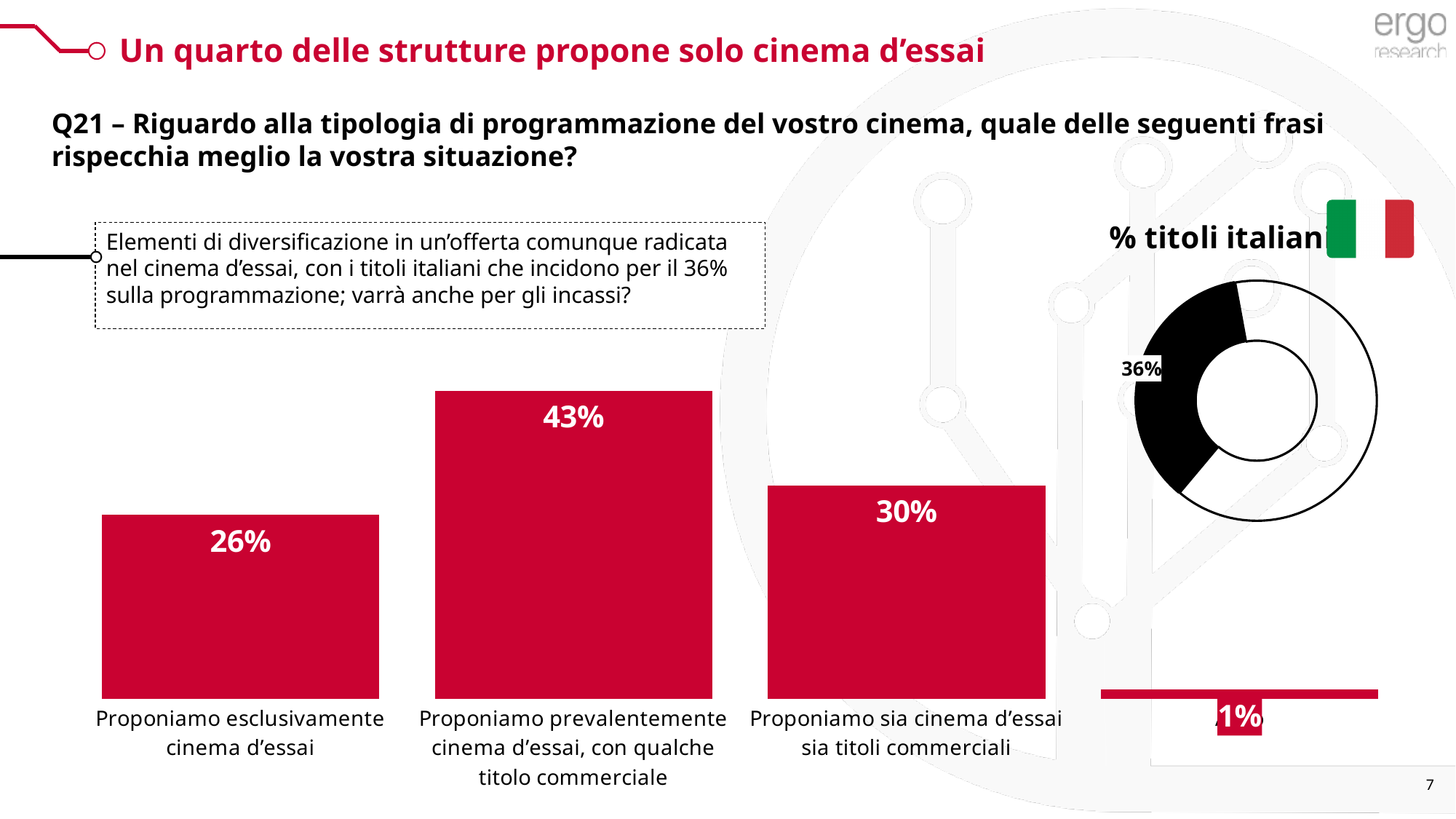
What kind of chart is the large chart on the left of the slide? Bar chart In the "% titoli italiani" chart, what share does the black slice represent? 36% In the bar chart, which is larger: the value for "Proponiamo sia cinema d'essai sia titoli commerciali" or for "Proponiamo esclusivamente cinema d'essai"? Proponiamo sia cinema d'essai sia titoli commerciali What colour are the bars in the bar chart? Red In the bar chart, what is the value for "Proponiamo sia cinema d'essai sia titoli commerciali"? 30% In the bar chart, which category has the highest value? Proponiamo prevalentemente cinema d'essai, con qualche titolo commerciale In the bar chart, what is the value for "Proponiamo esclusivamente cinema d'essai"? 26% In the bar chart, what is the value for "Proponiamo prevalentemente cinema d'essai, con qualche titolo commerciale"? 43% In the bar chart, what is the difference between the values for "Proponiamo prevalentemente cinema d'essai, con qualche titolo commerciale" and "Proponiamo esclusivamente cinema d'essai"? 17 percentage points In the bar chart, what is the difference between the values for "Proponiamo prevalentemente cinema d'essai, con qualche titolo commerciale" and "Proponiamo sia cinema d'essai sia titoli commerciali"? 13 percentage points What kind of chart is the "% titoli italiani" chart on the right? Donut chart What is the title of the donut chart on the right of the slide? % titoli italiani